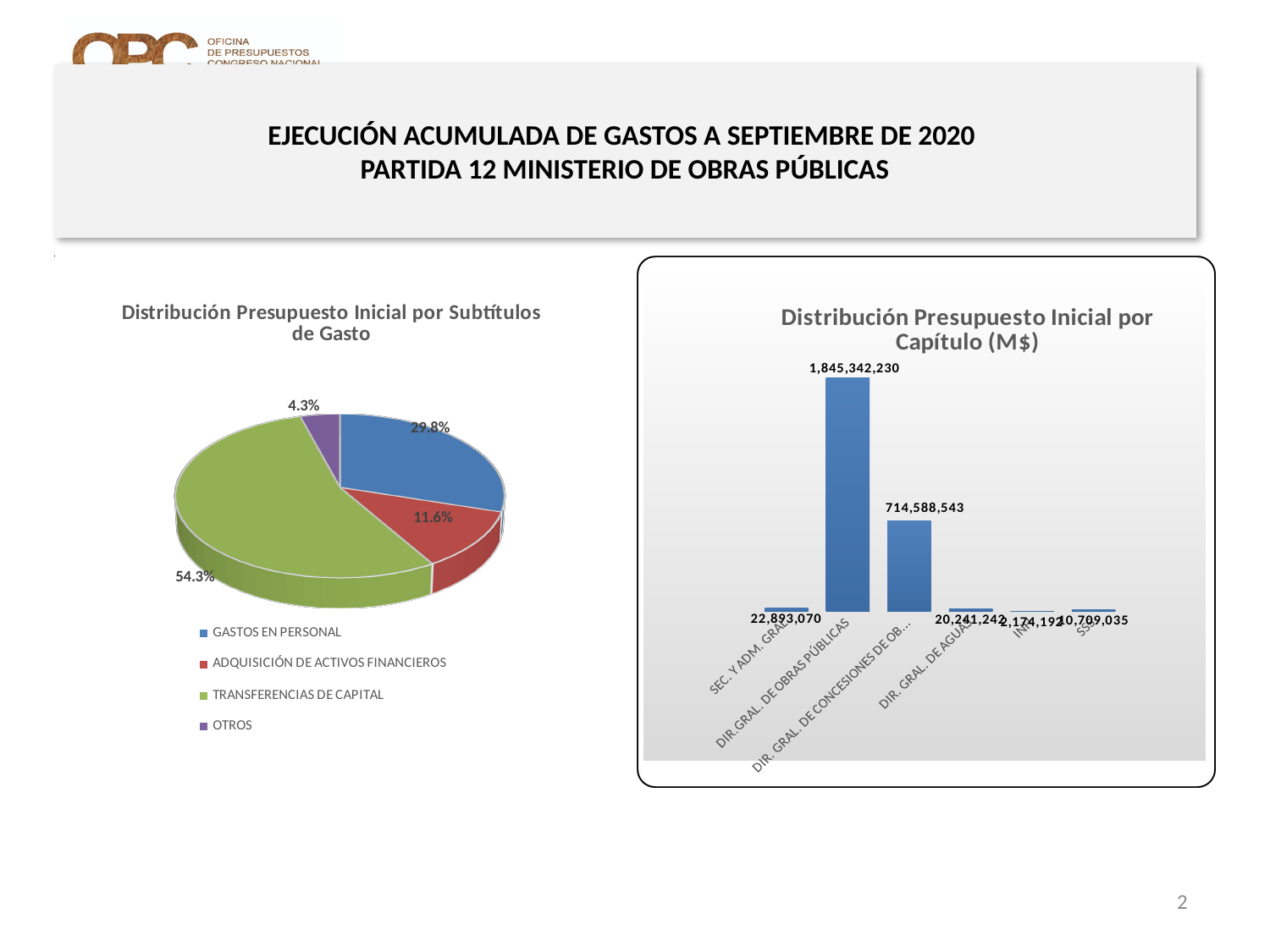
In the chart 'Distribución Presupuesto Inicial por Capítulo (M$)', how many bars are plotted? 6 In the pie chart 'Distribución Presupuesto Inicial por Subtítulos de Gasto', which category has the smallest slice? OTROS What kind of chart is the one on the left of the slide, 'Distribución Presupuesto Inicial por Subtítulos de Gasto'? Pie chart In the pie chart 'Distribución Presupuesto Inicial por Subtítulos de Gasto', what percentage is shown for GASTOS EN PERSONAL? 29.8% In the chart 'Distribución Presupuesto Inicial por Capítulo (M$)', which capítulo has the highest value? DIR.GRAL. DE OBRAS PÚBLICAS What kind of chart is 'Distribución Presupuesto Inicial por Capítulo (M$)'? Bar chart In the pie chart 'Distribución Presupuesto Inicial por Subtítulos de Gasto', which category has the largest slice? TRANSFERENCIAS DE CAPITAL In the pie chart 'Distribución Presupuesto Inicial por Subtítulos de Gasto', how many categories does the legend list? 4 In the pie chart 'Distribución Presupuesto Inicial por Subtítulos de Gasto', what is the difference in percentage points between GASTOS EN PERSONAL and ADQUISICIÓN DE ACTIVOS FINANCIEROS? 18.2% In the chart 'Distribución Presupuesto Inicial por Capítulo (M$)', what is the value for SEC. Y ADM. GRAL.? 22,893,070 In the chart 'Distribución Presupuesto Inicial por Capítulo (M$)', what is the value for DIR.GRAL. DE OBRAS PÚBLICAS? 1,845,342,230 In the pie chart 'Distribución Presupuesto Inicial por Subtítulos de Gasto', what share does TRANSFERENCIAS DE CAPITAL have? 54.3%